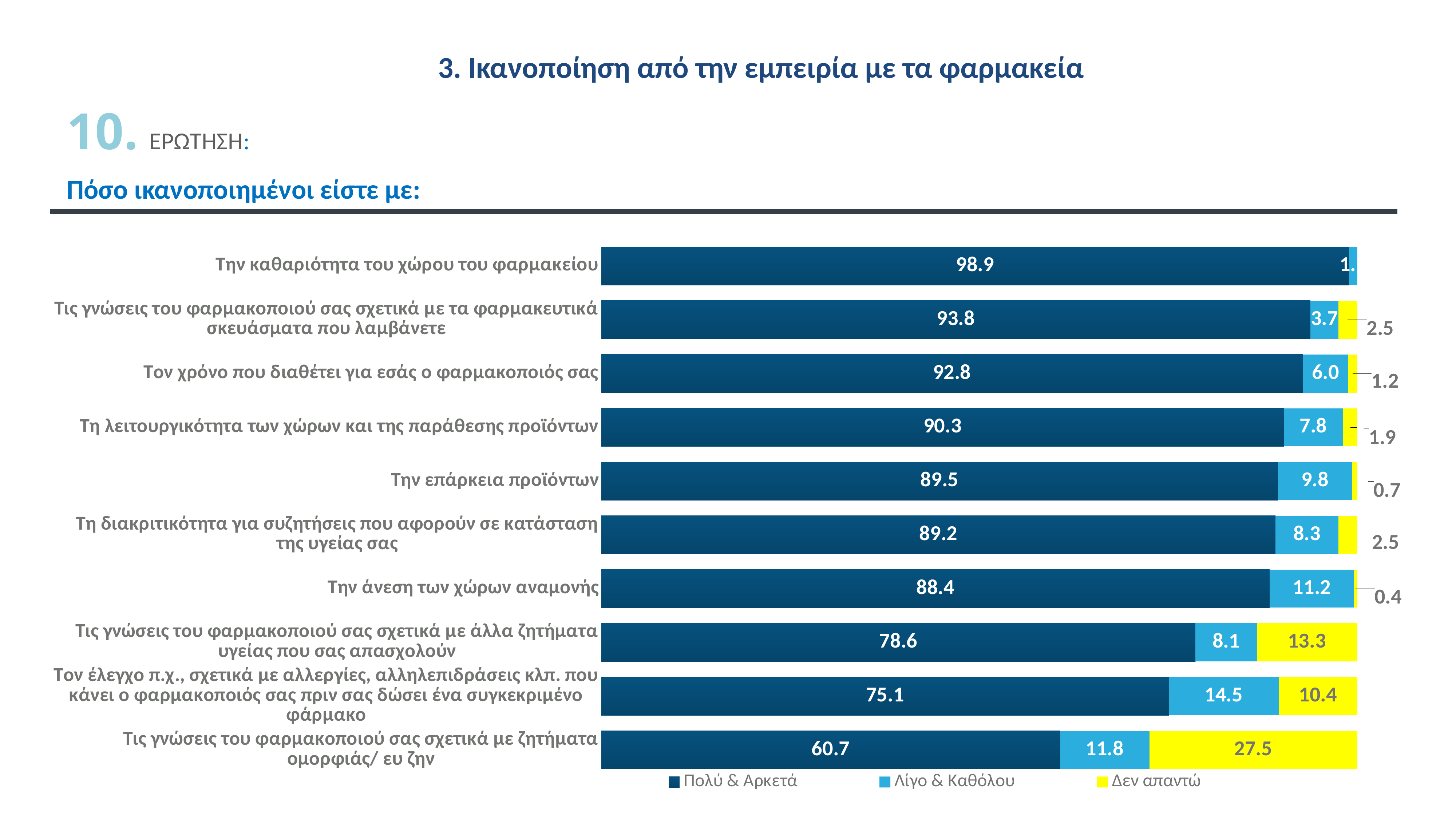
Which is larger: the 'Δεν απαντώ' value for 'Τις γνώσεις του φαρμακοποιού σας σχετικά με άλλα ζητήματα υγείας που σας απασχολούν' or for 'Τον έλεγχο π.χ., σχετικά με αλλεργίες, αλληλεπιδράσεις κλπ. που κάνει ο φαρμακοποιός σας πριν σας δώσει ένα συγκεκριμένο φάρμακο'? Τις γνώσεις του φαρμακοποιού σας σχετικά με άλλα ζητήματα υγείας που σας απασχολούν What kind of chart is shown on the slide? stacked bar chart What is the difference between the 'Πολύ & Αρκετά' values for 'Την καθαριότητα του χώρου του φαρμακείου' and 'Τις γνώσεις του φαρμακοποιού σας σχετικά με ζητήματα ομορφιάς/ ευ ζην'? 38.2 How many series does the legend list? 3 What is the 'Πολύ & Αρκετά' value for 'Την καθαριότητα του χώρου του φαρμακείου'? 98.9 How many categories are plotted in the chart? 10 Which category has the highest 'Λίγο & Καθόλου' value? Τον έλεγχο π.χ., σχετικά με αλλεργίες, αλληλεπιδράσεις κλπ. που κάνει ο φαρμακοποιός σας πριν σας δώσει ένα συγκεκριμένο φάρμακο What is the 'Δεν απαντώ' value for 'Τις γνώσεις του φαρμακοποιού σας σχετικά με ζητήματα ομορφιάς/ ευ ζην'? 27.5 What is the total of the stacked bar for 'Τον έλεγχο π.χ., σχετικά με αλλεργίες, αλληλεπιδράσεις κλπ. που κάνει ο φαρμακοποιός σας πριν σας δώσει ένα συγκεκριμένο φάρμακο'? 100.0 What is the 'Λίγο & Καθόλου' value for 'Τον χρόνο που διαθέτει για εσάς ο φαρμακοποιός σας'? 6.0 Which category has the lowest 'Πολύ & Αρκετά' value? Τις γνώσεις του φαρμακοποιού σας σχετικά με ζητήματα ομορφιάς/ ευ ζην Which colour represents the 'Δεν απαντώ' series in the chart? yellow